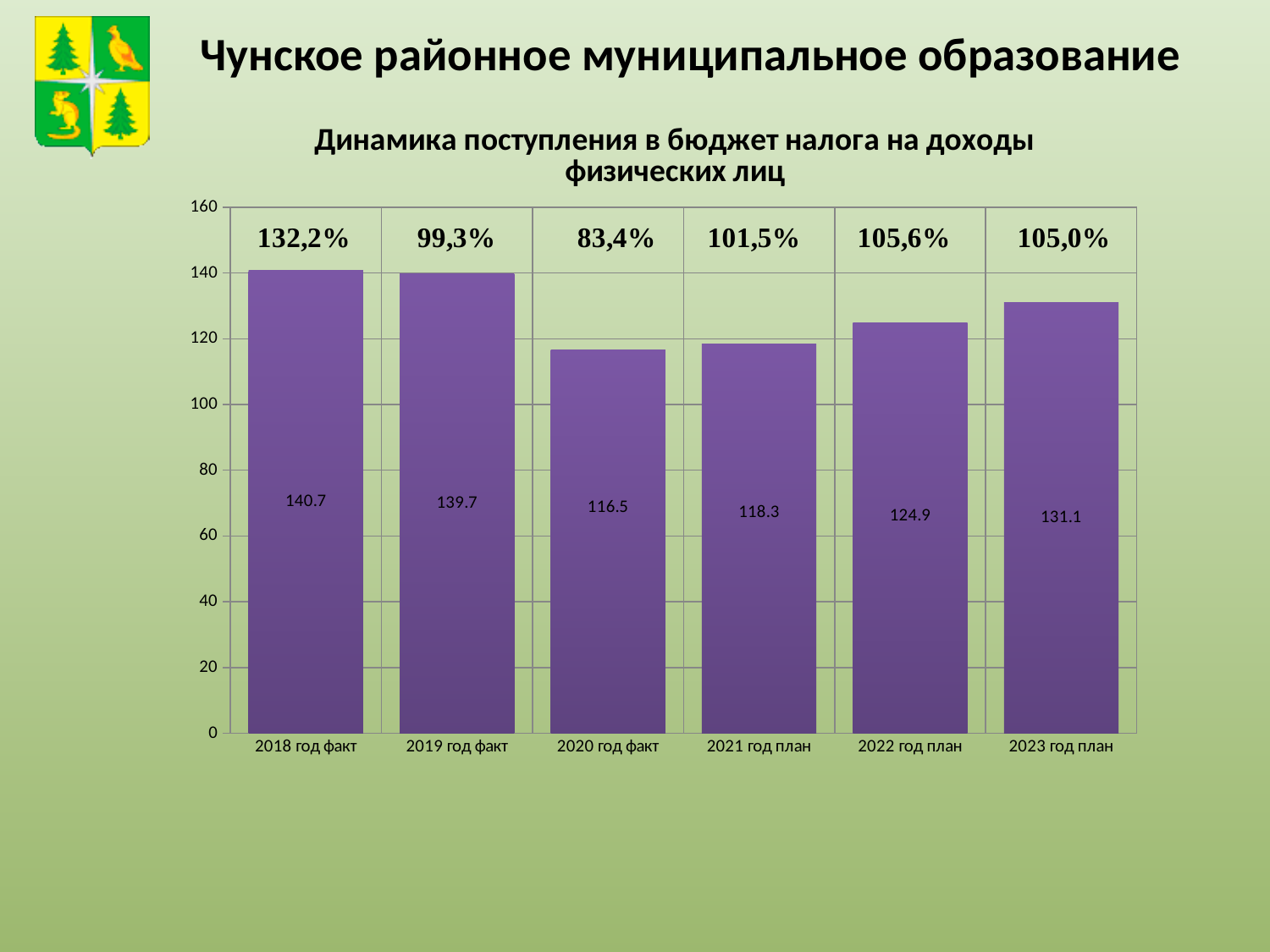
Which category has the lowest value? 2020 год факт What is the value for 2023 год план? 131.1 What kind of chart is shown on the slide? bar chart How many categories are shown on the x axis? 6 What percentage is shown above the bar for 2021 год план? 101,5% Is the value for 2019 год факт greater or less than 120? greater Which is larger, the value for 2021 год план or the value for 2022 год план? 2022 год план What is the value for 2020 год факт? 116.5 What is the value for 2018 год факт? 140.7 Do the values rise or fall from 2020 год факт to 2023 год план? rise What is the difference between the values for 2023 год план and 2022 год план? 6.2 Which category has the highest value? 2018 год факт